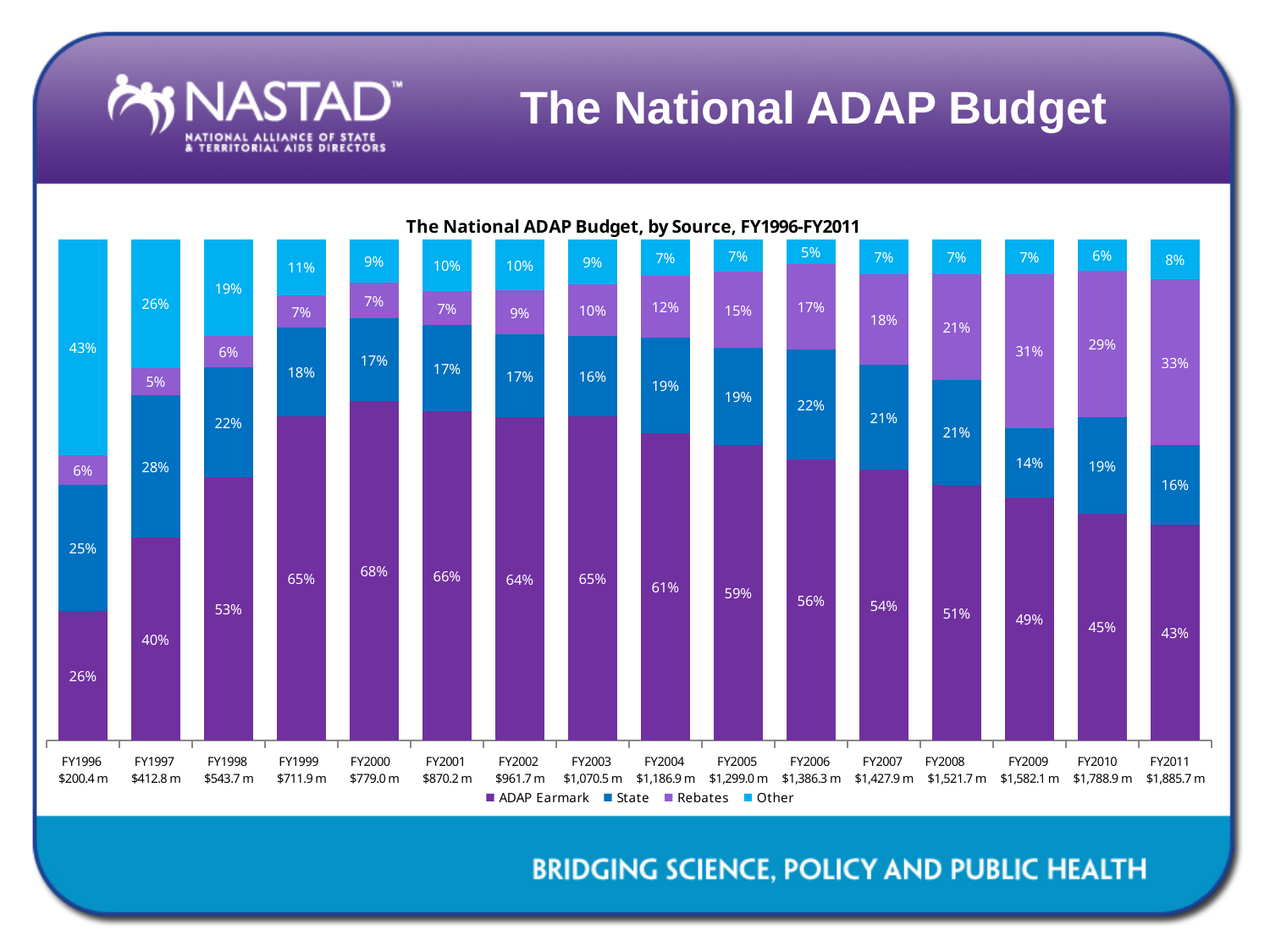
Does the Rebates share rise or fall from FY2004 to FY2011? Rise By how many percentage points did the ADAP Earmark share fall from FY2000 to FY2011? 25 percentage points What kind of chart is shown on the slide? Stacked bar chart How many fiscal years are shown on the x axis? 16 How many series does the legend list? 4 Which year had a larger State share, FY1997 or FY2011? FY1997 What share of the budget came from the ADAP Earmark in FY2000? 68% In which fiscal year was the ADAP Earmark share the lowest? FY1996 In which fiscal year was the ADAP Earmark share the highest? FY2000 What is the total budget amount shown under the FY2011 bar? $1,885.7 m What share of the budget came from Rebates in FY2011? 33% What share of the budget came from Other sources in FY1996? 43%